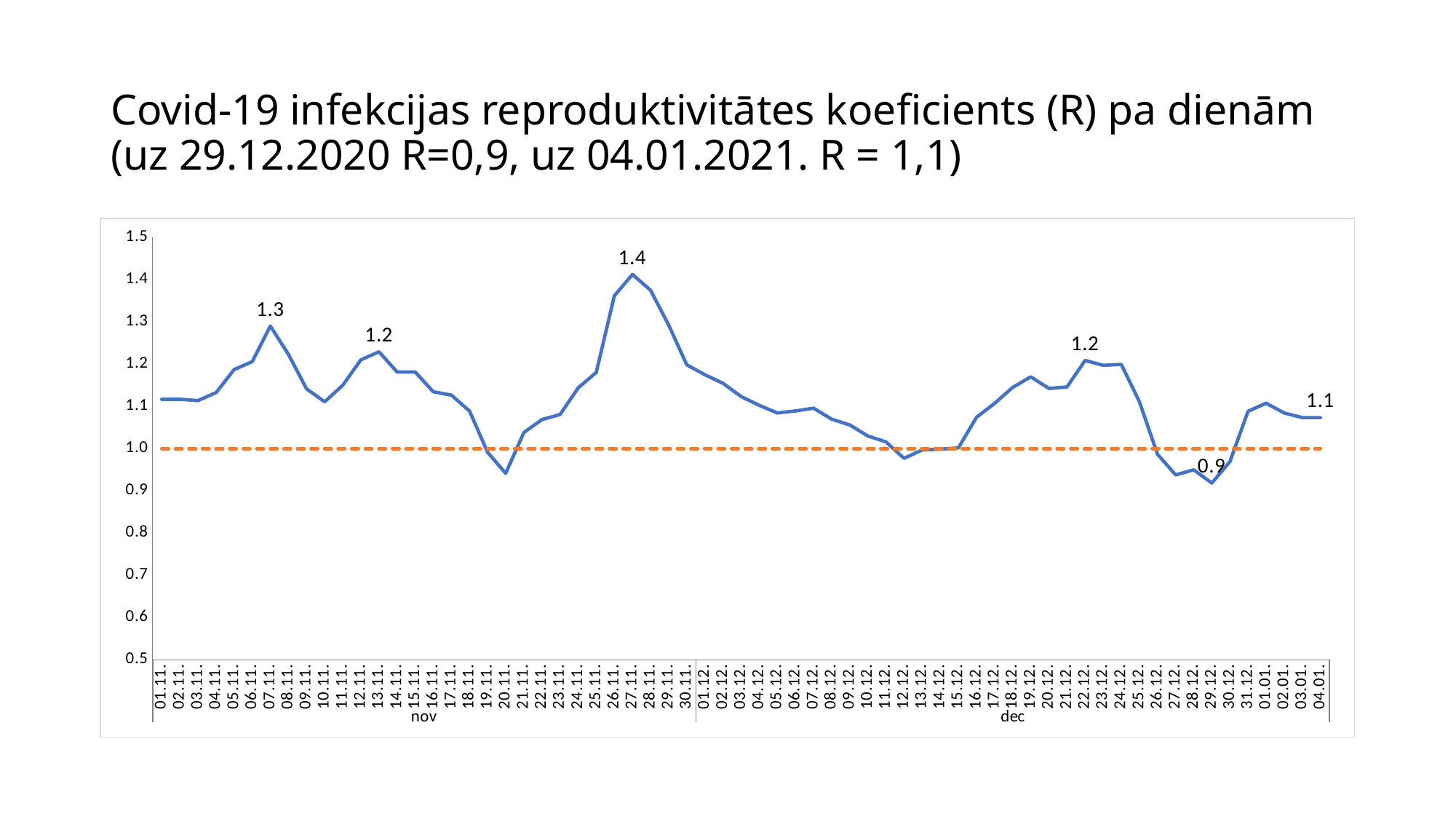
Which is larger, the value on 07.11. or the value on 27.11.? 27.11. On which date does the line reach its highest value? 27.11. What kind of chart is shown on the slide? line chart What is the value of R on 07.11.? 1.3 Among the labeled points, which date has the lowest value? 29.12. What is the value of R on 27.11.? 1.4 What is the difference between the value on 27.11. and the value on 29.12.? 0.5 What is the value of R on 04.01.? 1.1 Is the value on 19.12. greater or less than 1.1? greater Do the values rise or fall from 27.11. to 12.12.? fall What is the value of R on 29.12.? 0.9 Is the value on 20.11. greater or less than 1.0? less